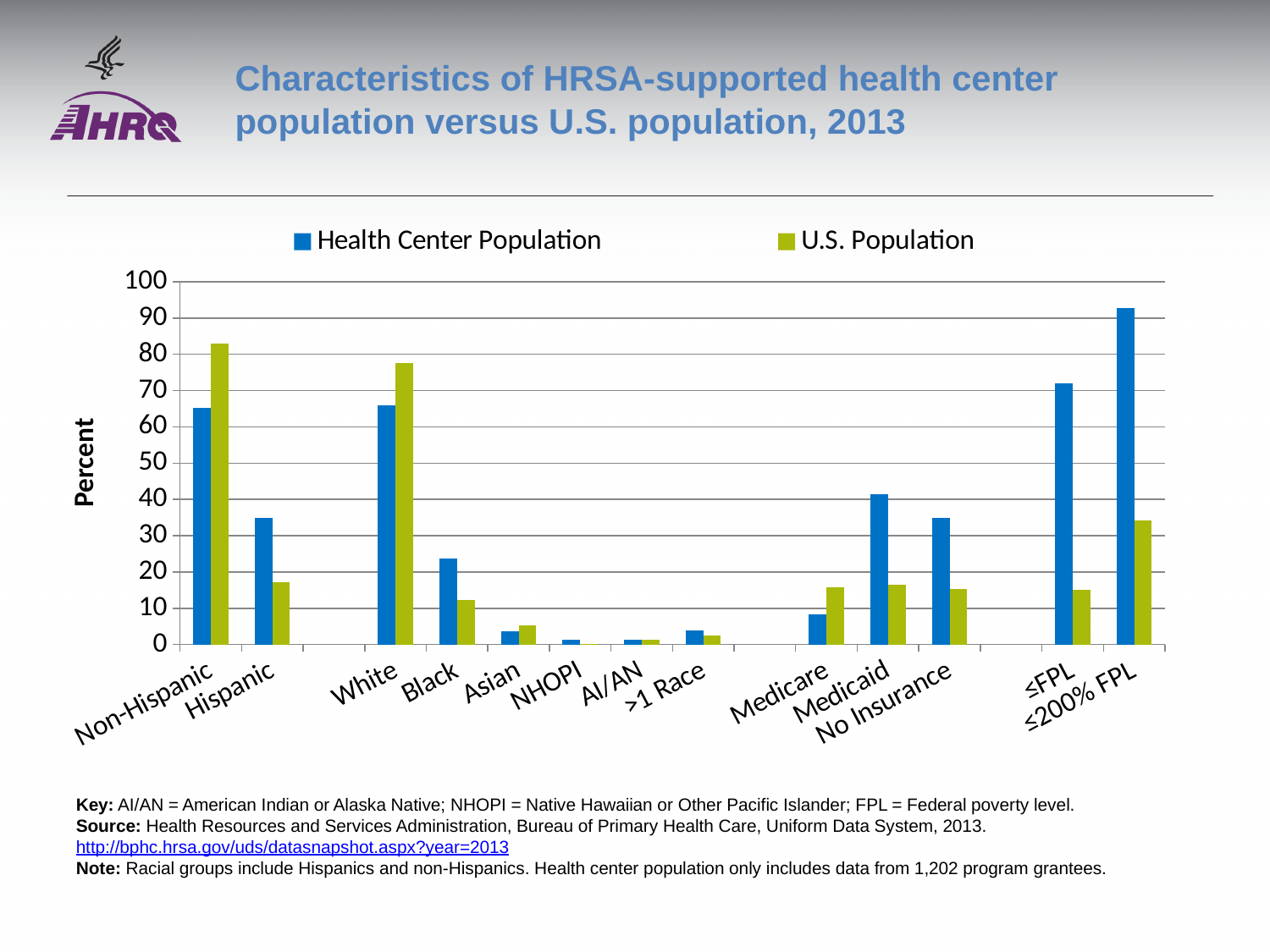
For Black, which series has the larger value, Health Center Population or U.S. Population? Health Center Population Which category has the highest Health Center Population value? ≤200% FPL How many series does the legend list? 2 Which category has the highest U.S. Population value? Non-Hispanic Is the Health Center Population value for Medicaid greater or less than 30? greater For White, which series has the larger value, Health Center Population or U.S. Population? U.S. Population Is the U.S. Population value for Hispanic greater or less than 20? less Is the U.S. Population value for ≤FPL greater or less than 20? less What is the label on the vertical axis? Percent What kind of chart is shown on the slide? bar chart How many categories are shown along the x axis? 13